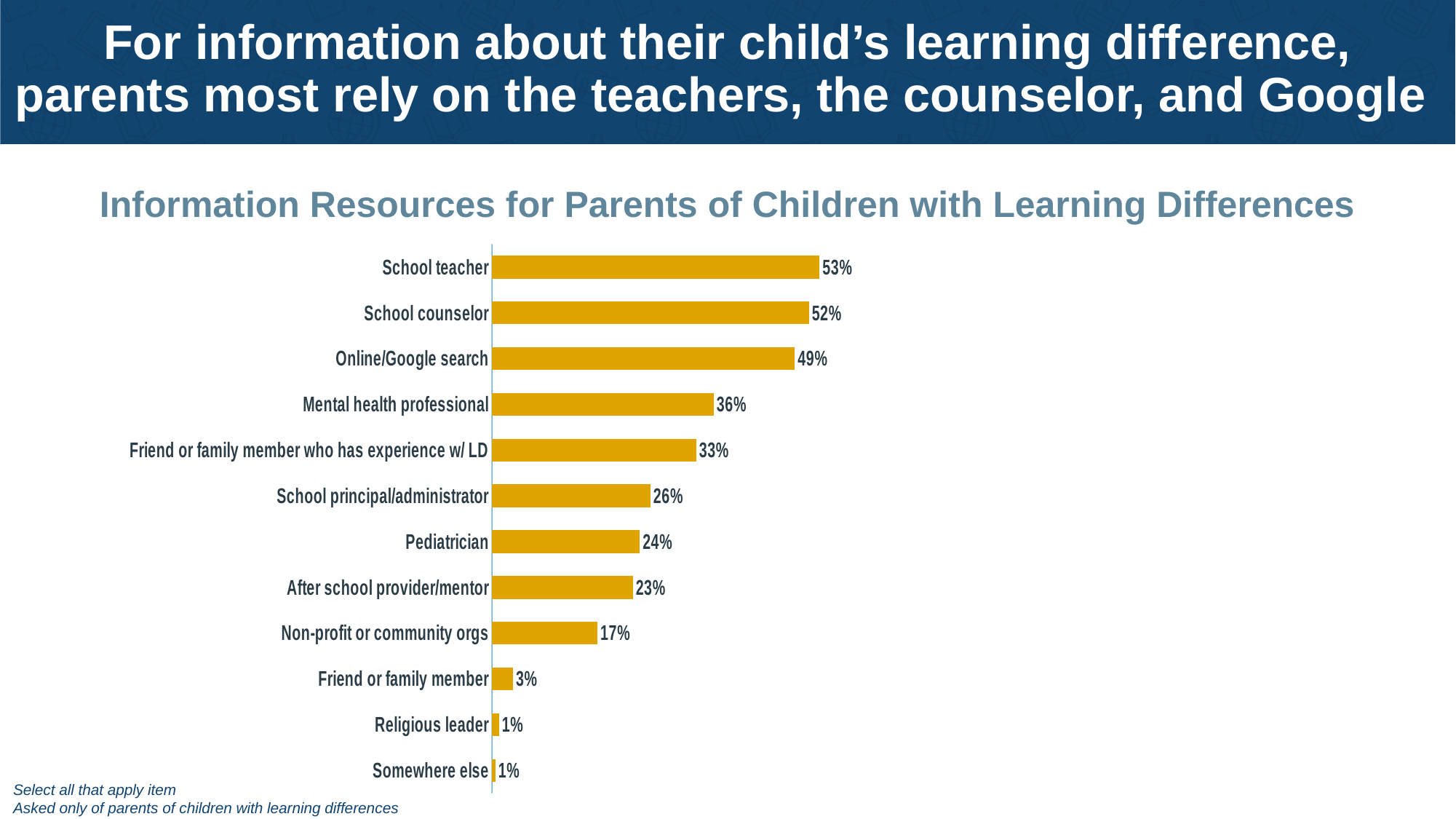
What is the value for Pediatrician? 24% Which is larger, the value for School principal/administrator or the value for After school provider/mentor? School principal/administrator What percentage of parents rely on the school teacher for information about their child's learning difference? 53% What is the difference between the values for School teacher and Online/Google search? 4% How many information resource categories are shown in the chart? 12 What is the difference between Mental health professional and Friend or family member who has experience w/ LD? 3% What is the value for Non-profit or community orgs? 17% What is the value for Online/Google search? 49% Which resource has the lowest percentage among those above 10%? Non-profit or community orgs What kind of chart is shown on the slide? Bar chart What is the title of the chart? Information Resources for Parents of Children with Learning Differences Which information resource has the highest percentage? School teacher